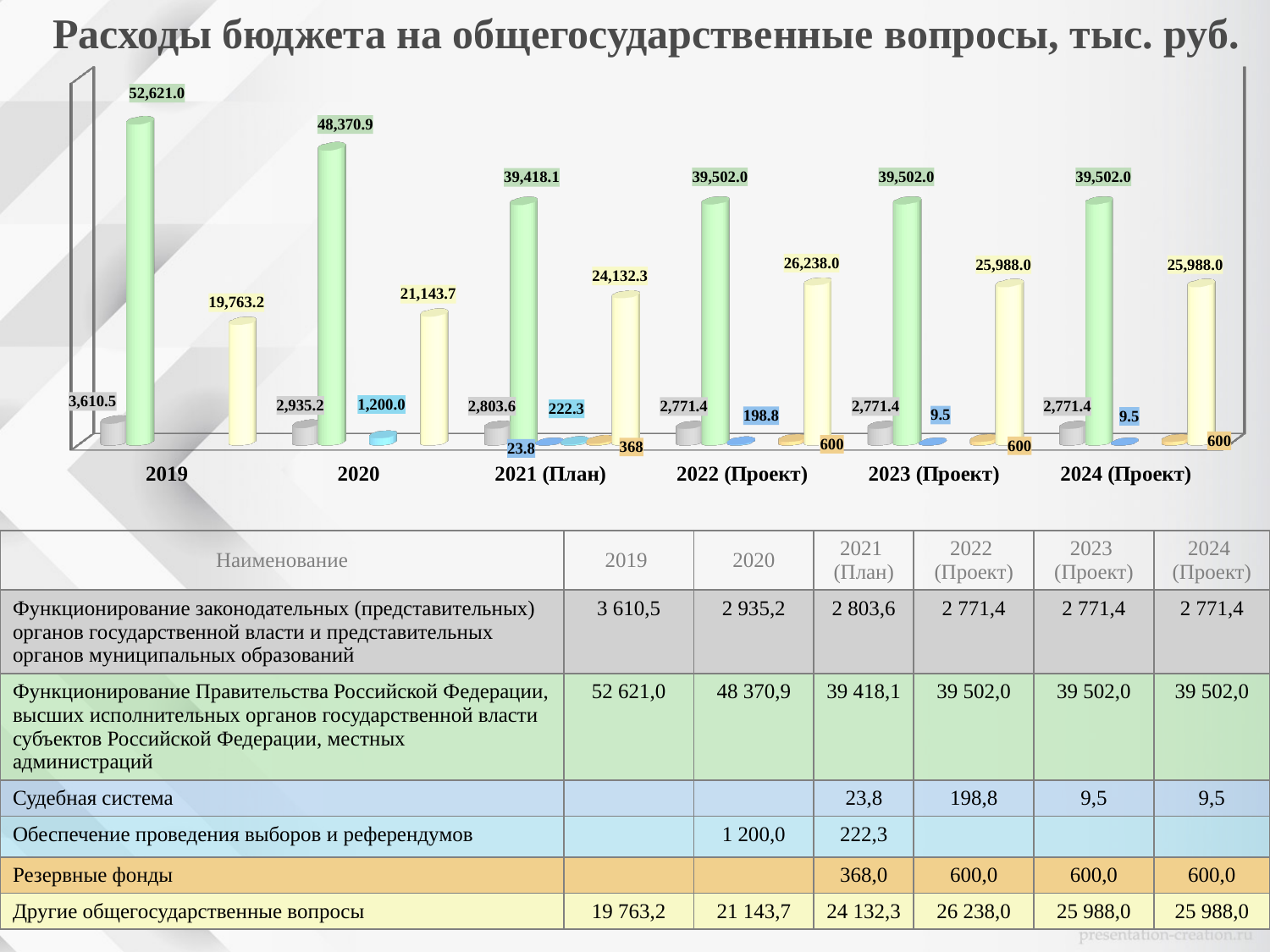
Which is larger in 2021 (План): the green bar (39,418.1) or the yellow bar (24,132.3)? The green bar (39,418.1) In which year is the yellow bar (Другие общегосударственные вопросы) lowest? 2019 Does the gray bar (Функционирование законодательных органов...) rise or fall from 2019 to 2021 (План)? Fall What is the value of the yellow bar (Другие общегосударственные вопросы) for 2022 (Проект)? 26,238.0 What type of chart is shown on the slide? Bar chart What is the difference between the green bar values for 2019 and 2020? 4,250.1 How many data series (rows) does the table below the chart list? 6 What is the value for Судебная система in 2021 (План)? 23.8 In which year is the green bar (Функционирование Правительства Российской Федерации...) highest? 2019 What is the value of the green bar (Функционирование Правительства Российской Федерации...) for 2019? 52,621.0 What is the value of the gray bar (Функционирование законодательных органов...) for 2020? 2,935.2 How many year categories are shown on the x axis of the chart? 6